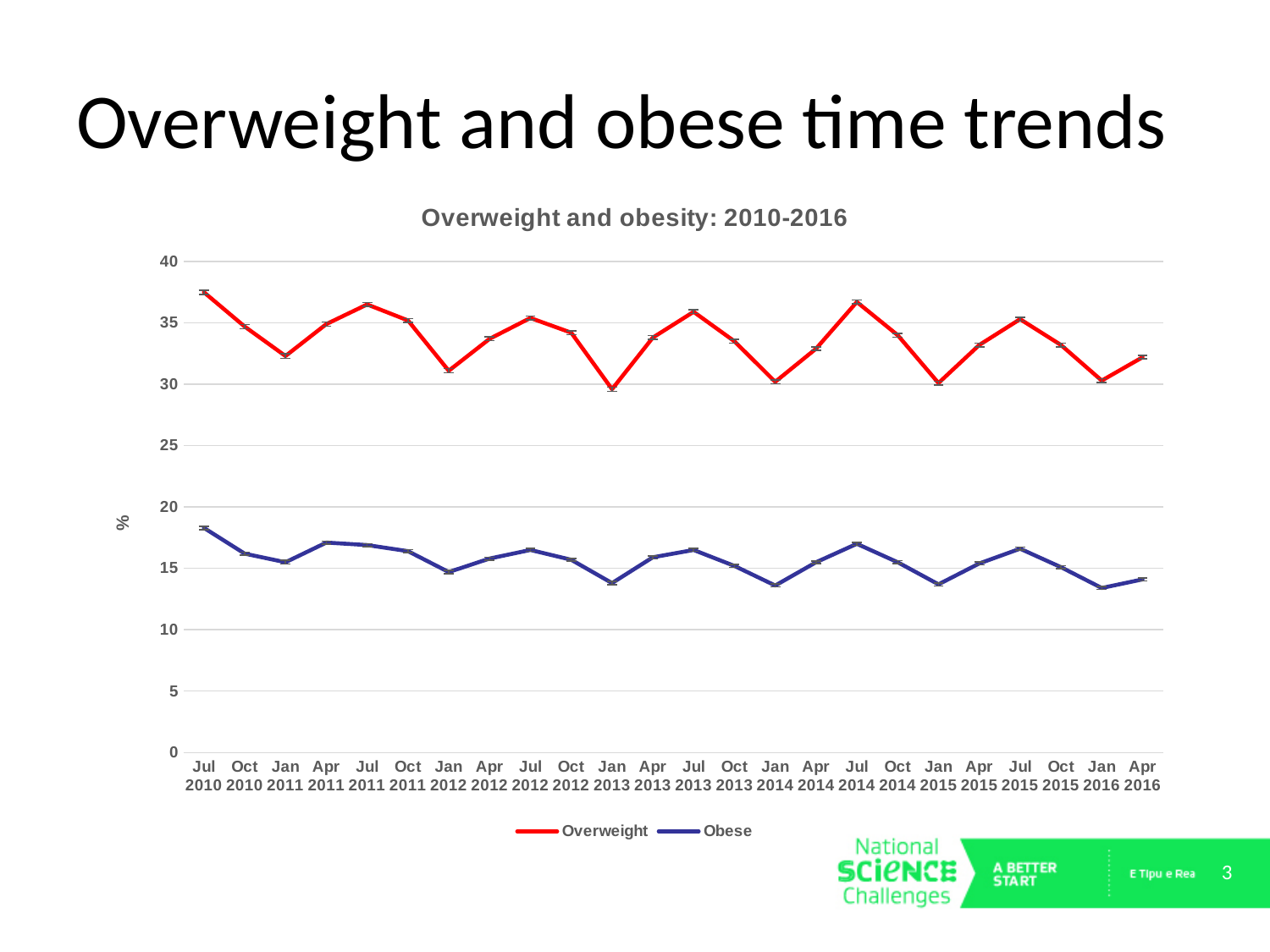
At which time point is the Obese series highest? Jul 2010 What is the title of the chart? Overweight and obesity: 2010-2016 Which colour is used for the Obese series? Blue Is the Obese value for Jul 2010 greater or less than 15? greater Is the Overweight value for Jan 2011 greater or less than 35? less Which series has the larger value in Apr 2016, Overweight or Obese? Overweight How many time points are plotted along the x axis? 24 Is the Overweight value for Jul 2010 greater or less than 35? greater What kind of chart is shown on the slide? Line chart How many series does the legend list? 2 Does the Overweight series rise or fall from Jul 2010 to Jan 2011? Fall